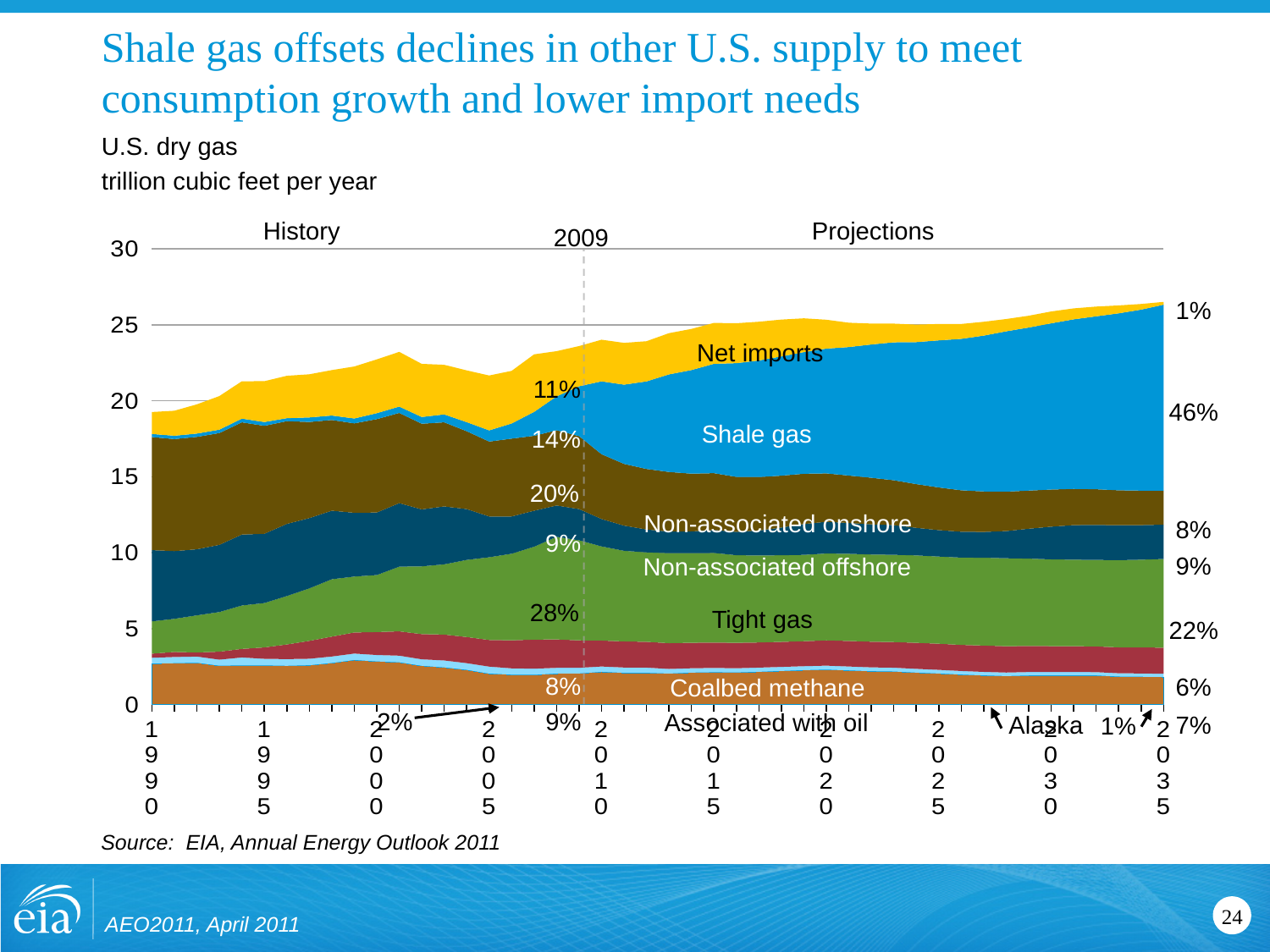
Is total U.S. dry gas in 2035 greater or less than 25 trillion cubic feet per year? greater Which source has the largest share of U.S. dry gas in 2009? Tight gas Does the shale gas area rise or fall from 2009 to 2035? rise By how many percentage points does the shale gas share change between 2009 (14%) and 2035 (46%)? 32 percentage points What percentage is shown for tight gas in 2009? 28% What share of U.S. dry gas does shale gas account for in 2009? 14% Which source has the smallest share of U.S. dry gas in 2009? Alaska What share of U.S. dry gas does shale gas account for in 2035 according to the chart? 46% What percentage is shown for net imports in 2035? 1% What unit is used on the chart's y axis? trillion cubic feet per year Which is larger in 2035: the share of tight gas or the share of non-associated onshore gas? Tight gas Which source has the largest share of U.S. dry gas in 2035? Shale gas